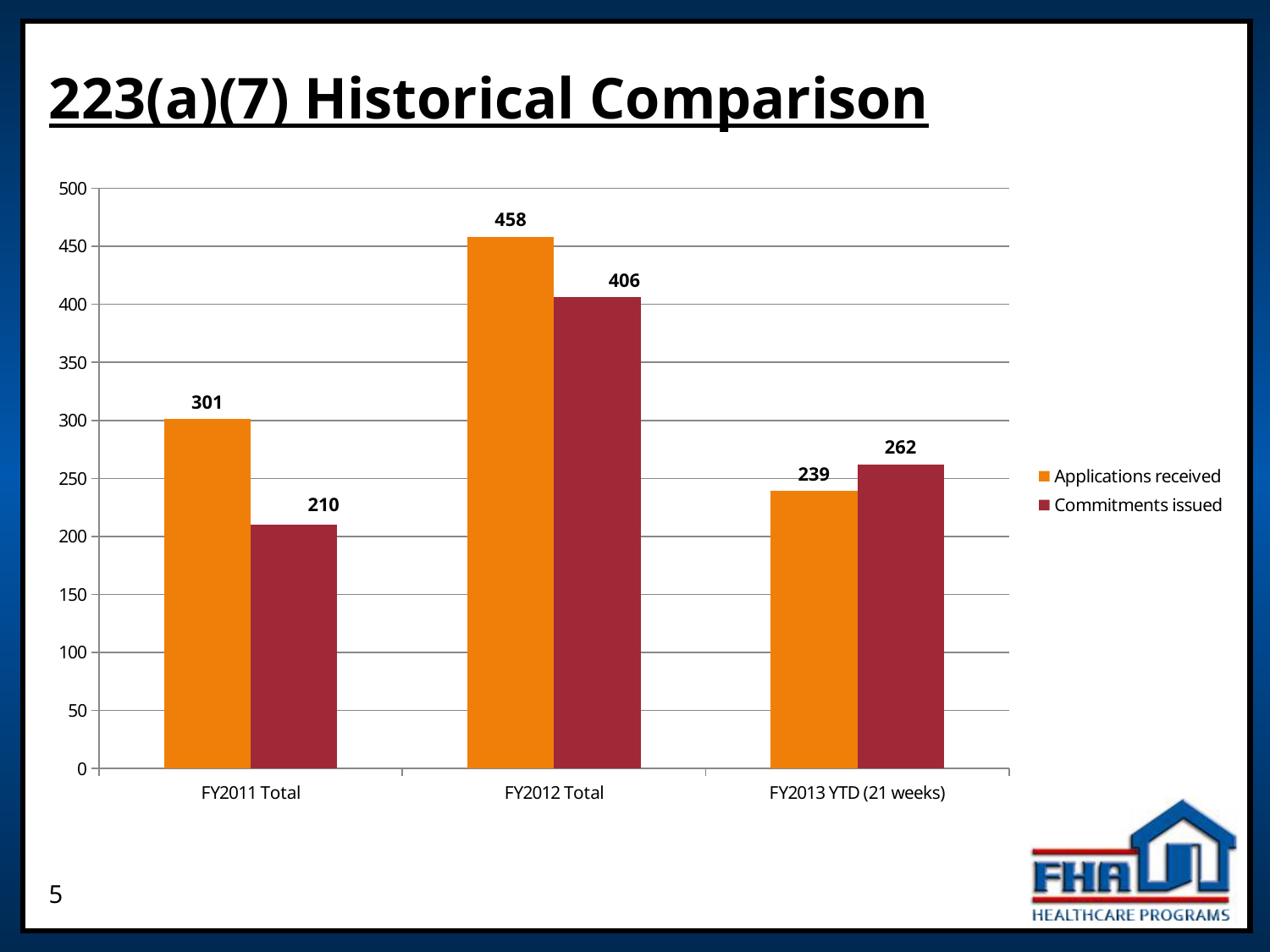
Which category has the lowest number of commitments issued? FY2011 Total Which category has the highest number of applications received? FY2012 Total How many categories are shown on the x axis? 3 What is the difference between applications received and commitments issued in FY2011 Total? 91 What kind of chart is shown on the slide? Bar chart What is the title of the slide? 223(a)(7) Historical Comparison What is the difference between applications received in FY2012 Total and FY2013 YTD (21 weeks)? 219 How many commitments were issued in FY2011 Total? 210 In FY2013 YTD (21 weeks), which is larger: applications received or commitments issued? Commitments issued How many applications were received in FY2012 Total? 458 How many series does the legend list? 2 What is the value for Commitments issued in FY2013 YTD (21 weeks)? 262